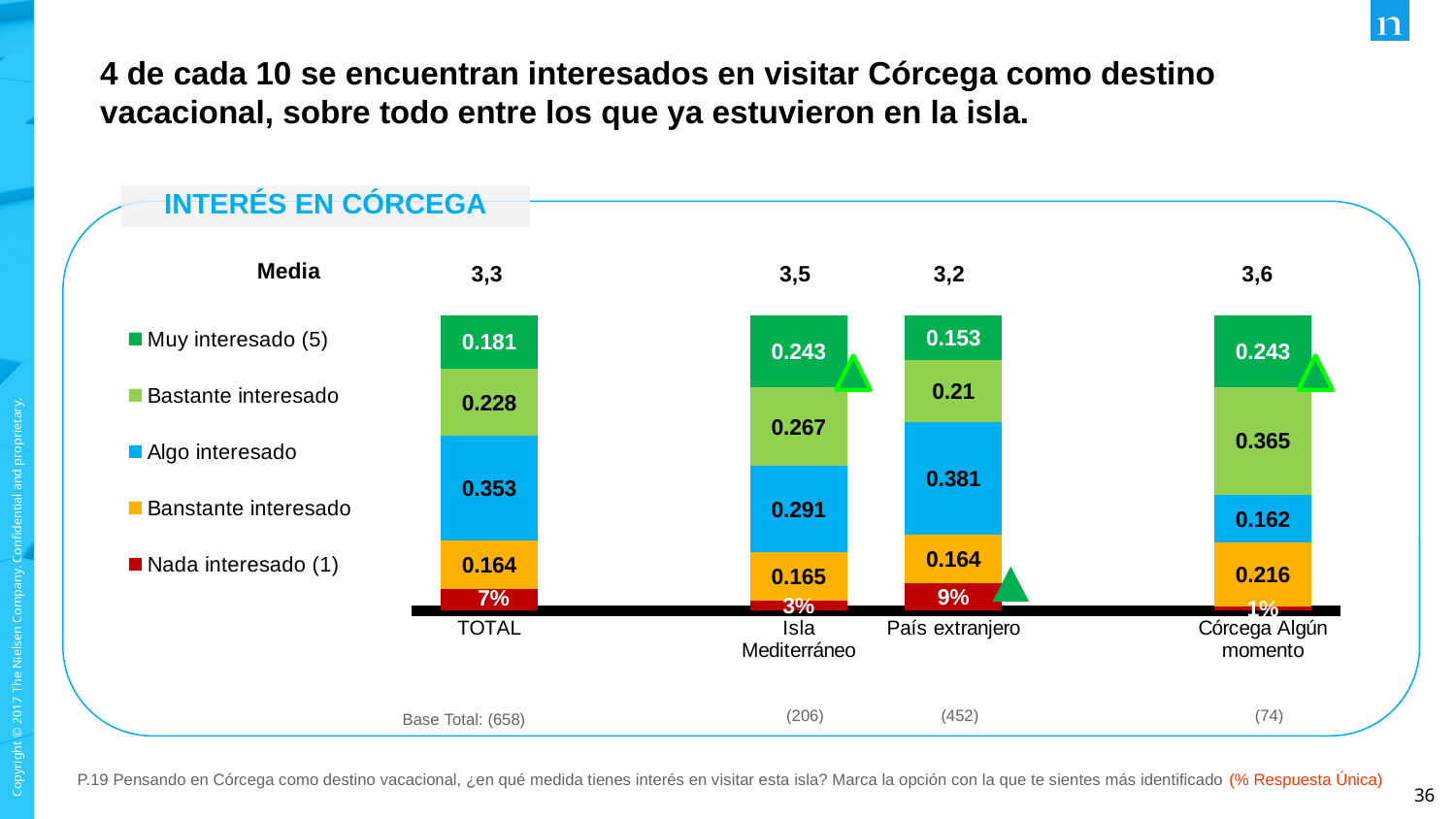
What is the value of 'Bastante interesado' for Córcega Algún momento? 0.365 What is the value of 'Algo interesado' for País extranjero? 0.381 How many categories are shown along the x axis of the chart? 4 Which category has the lowest value for 'Nada interesado (1)'? Córcega Algún momento How many series does the chart legend list? 5 Which is larger, the 'Bastante interesado' value for Córcega Algún momento or for Isla Mediterráneo? Córcega Algún momento Which category has the highest value for 'Algo interesado'? País extranjero What is the title of the chart? INTERÉS EN CÓRCEGA What is the difference between the 'Algo interesado' values for TOTAL and Córcega Algún momento? 0.191 What is the value of 'Nada interesado (1)' for Isla Mediterráneo? 3% What type of chart is shown on the slide? Stacked bar chart What is the value of 'Muy interesado (5)' for TOTAL? 0.181